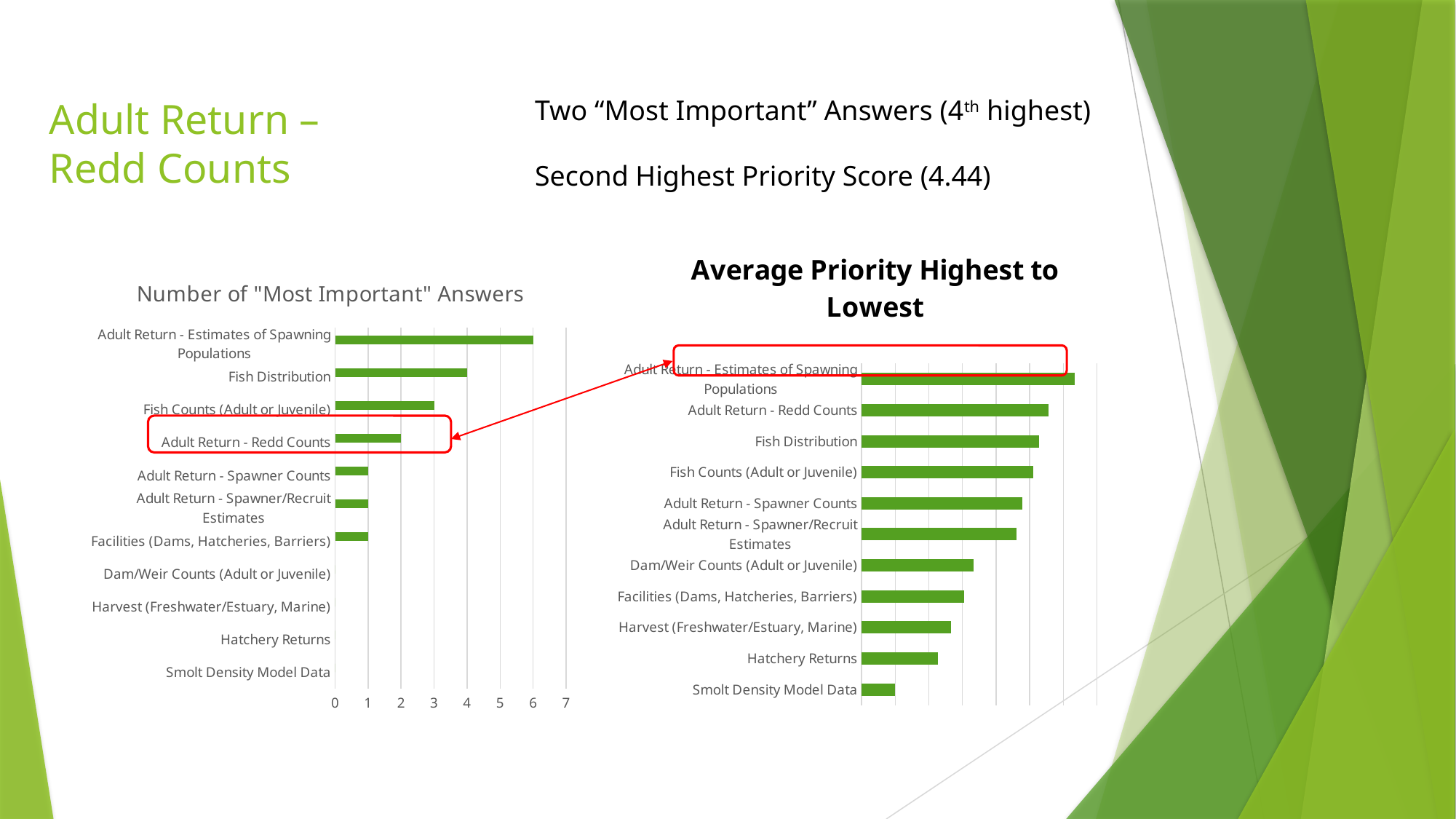
In the "Number of "Most Important" Answers" chart, what is the value for Adult Return - Estimates of Spawning Populations? 6 In the "Number of "Most Important" Answers" chart, what is the highest value shown on the horizontal axis? 7 In the "Average Priority Highest to Lowest" chart, which category has the shortest bar? Smolt Density Model Data In the "Number of "Most Important" Answers" chart, what is the difference between Fish Distribution and Fish Counts (Adult or Juvenile)? 1 In the "Average Priority Highest to Lowest" chart, which category has the longest bar? Adult Return - Estimates of Spawning Populations In the "Number of "Most Important" Answers" chart, what is the value for Adult Return - Redd Counts? 2 In the "Number of "Most Important" Answers" chart, what is the value for Fish Distribution? 4 In the "Number of "Most Important" Answers" chart, how many categories are listed on the vertical axis? 11 What kind of chart is the "Average Priority Highest to Lowest" chart? Bar chart In the "Number of "Most Important" Answers" chart, which category has the highest value? Adult Return - Estimates of Spawning Populations In the "Average Priority Highest to Lowest" chart, which has the longer bar: Adult Return - Redd Counts or Hatchery Returns? Adult Return - Redd Counts In the "Number of "Most Important" Answers" chart, which is larger: Fish Counts (Adult or Juvenile) or Adult Return - Spawner Counts? Fish Counts (Adult or Juvenile)